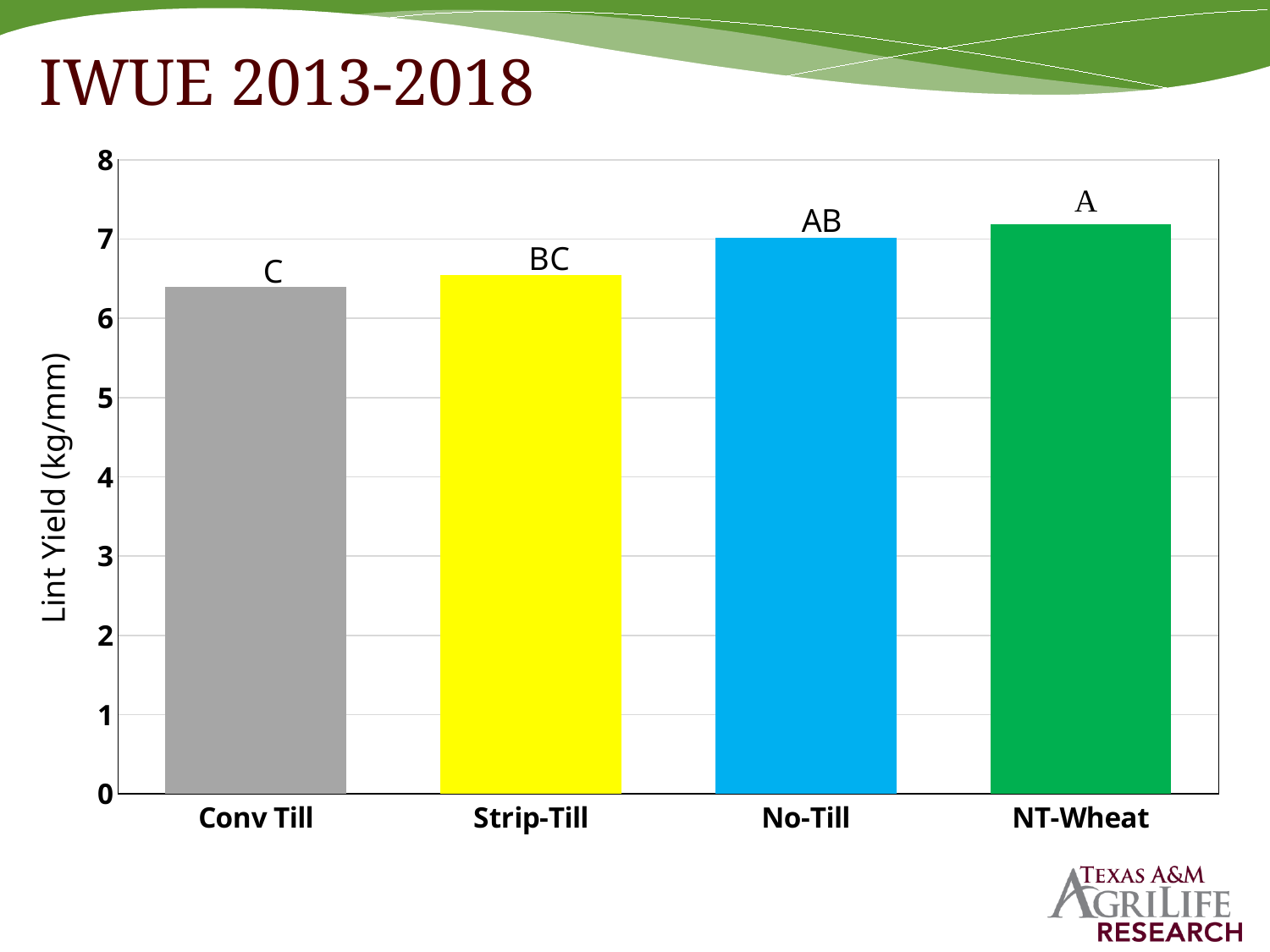
Do the bar values rise or fall from left to right across the x axis? rise What is the label on the y axis? Lint Yield (kg/mm) Is the value for NT-Wheat greater or less than 7? greater Which has the larger lint yield, Conv Till or NT-Wheat? NT-Wheat What letter label is printed above the NT-Wheat bar? A Is the value for Strip-Till greater or less than 7? less What kind of chart is shown on the slide? bar chart How many categories are plotted on the x axis? 4 Which category has the highest lint yield? NT-Wheat Which has the larger lint yield, No-Till or Strip-Till? No-Till Which category has the lowest lint yield? Conv Till Is the value for Conv Till greater or less than 6? greater